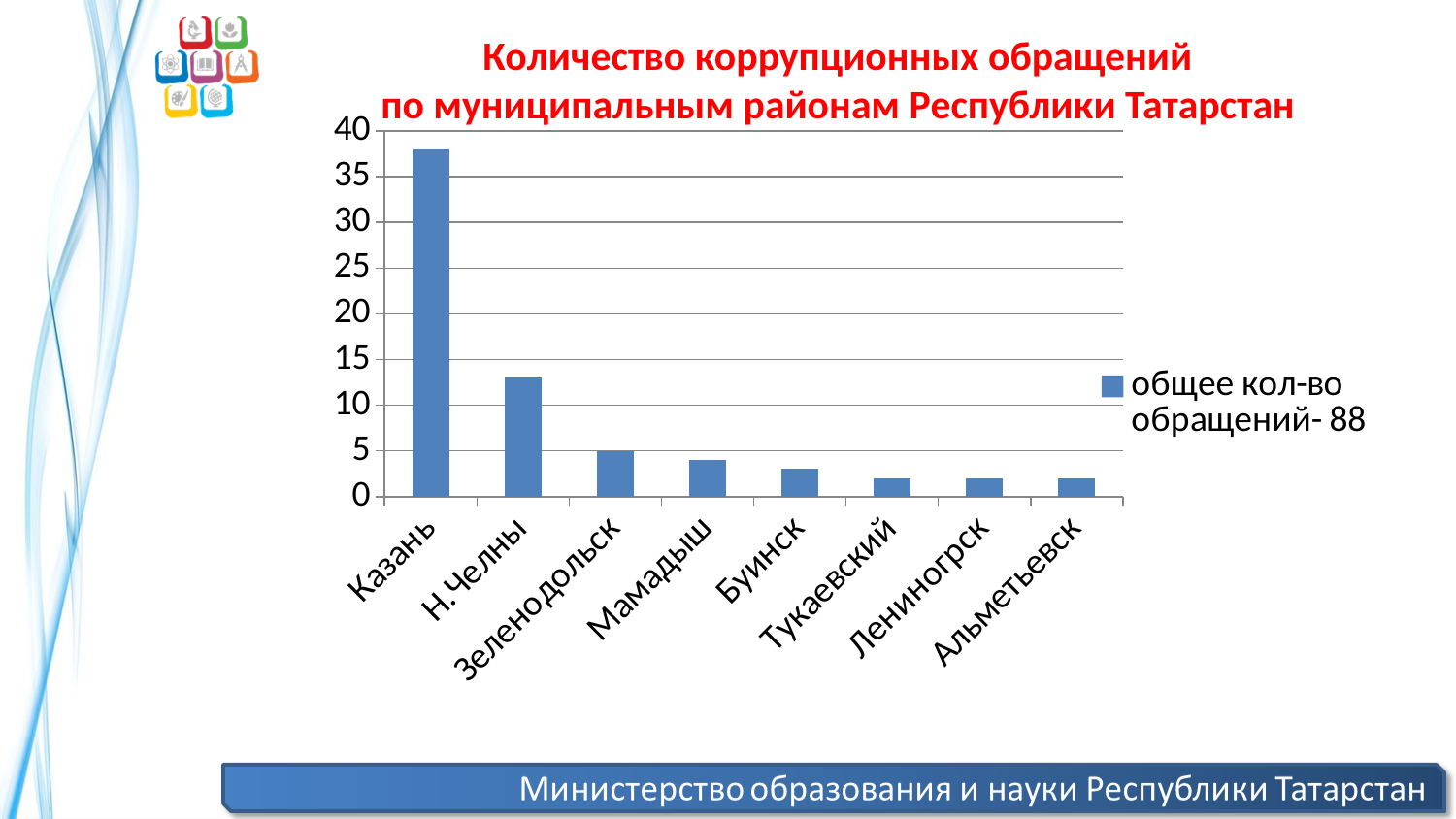
Is the value for Н.Челны greater or less than 10? greater Is the value for Буинск greater or less than 5? less How many municipal districts (categories) are shown on the x axis? 8 Which has more corruption appeals, Казань or Н.Челны? Казань What total number of appeals is stated in the legend entry? 88 Is the value for Казань greater or less than 35? greater Do the values rise or fall moving from left to right along the x axis? fall Which district has the highest number of corruption appeals? Казань How many series does the legend list? 1 What kind of chart is shown on the slide? bar chart What is the title of the chart? Количество коррупционных обращений по муниципальным районам Республики Татарстан Which has more corruption appeals, Н.Челны or Зеленодольск? Н.Челны